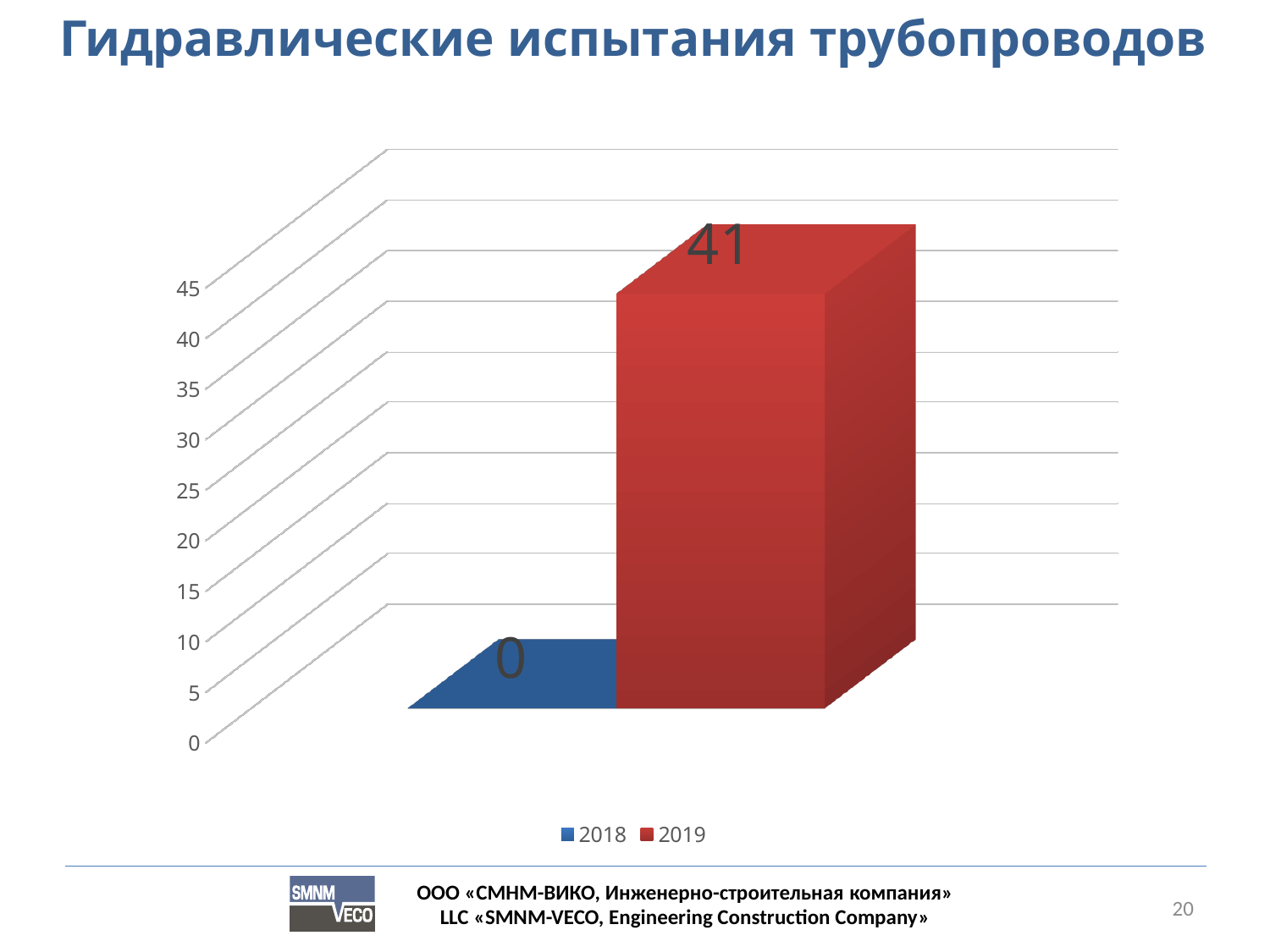
What is the value for 2018? 0 How many series does the legend list? 2 Is the value for 2019 greater or less than 45? less What is the difference between the 2019 value and the 2018 value? 41 Which year has the higher value, 2018 or 2019? 2019 Which series has the highest value? 2019 What is the value for 2019? 41 What is the title of the slide? Гидравлические испытания трубопроводов Is the value for 2019 greater or less than 40? greater What kind of chart is shown on the slide? bar chart What colour is the bar for 2019? red Which series has the lowest value? 2018